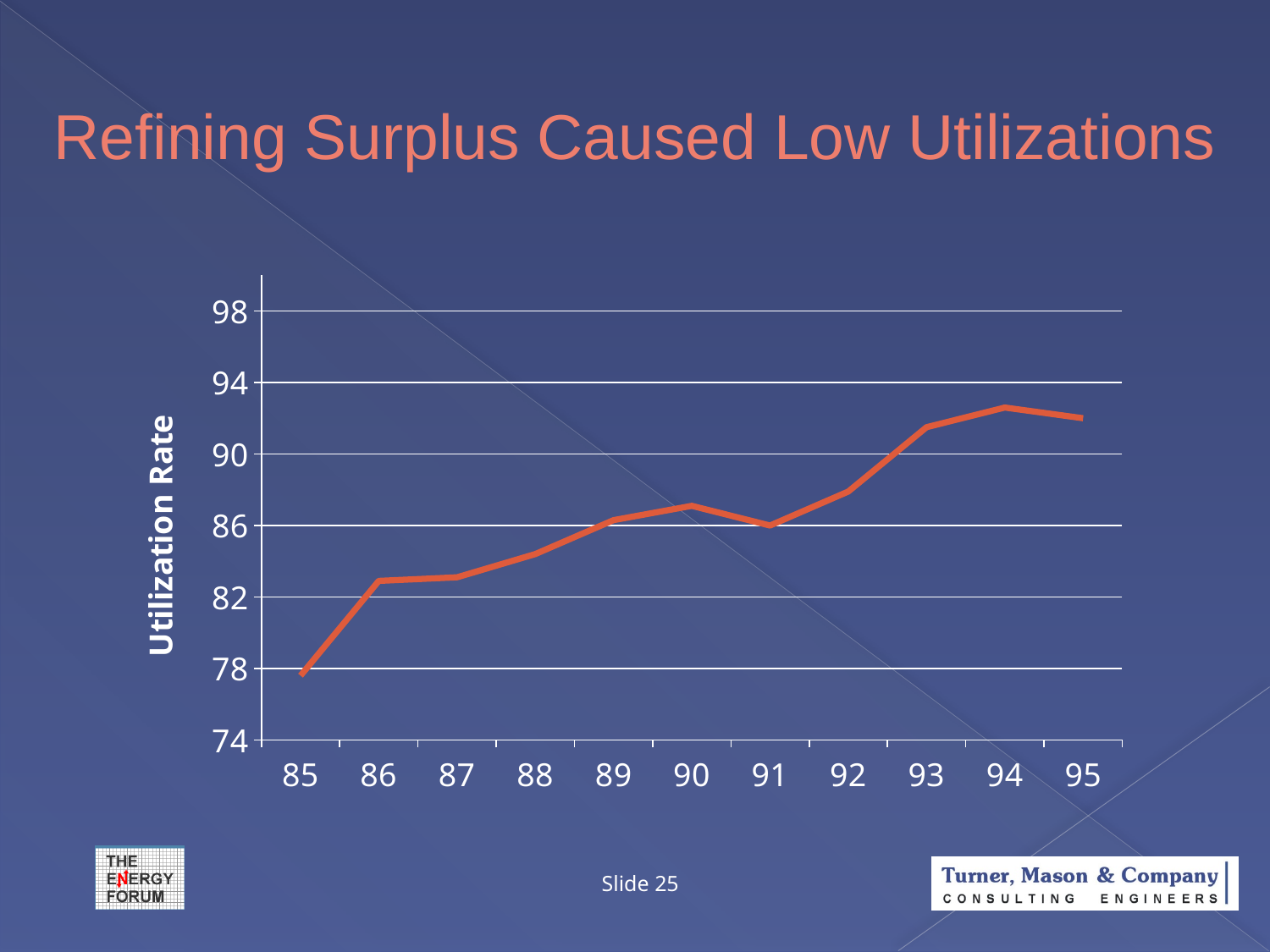
Does the utilization rate generally rise or fall from 85 to 95? rise How many years are plotted on the x axis? 11 Which year has the highest utilization rate? 94 Which year has the lowest utilization rate? 85 Is the utilization rate for 88 greater or less than 86? less Which year has a higher utilization rate, 88 or 92? 92 What kind of chart is shown on the slide? line chart Is the utilization rate for 86 greater or less than 82? greater Is the utilization rate for 85 greater or less than 78? less Which year has a higher utilization rate, 90 or 91? 90